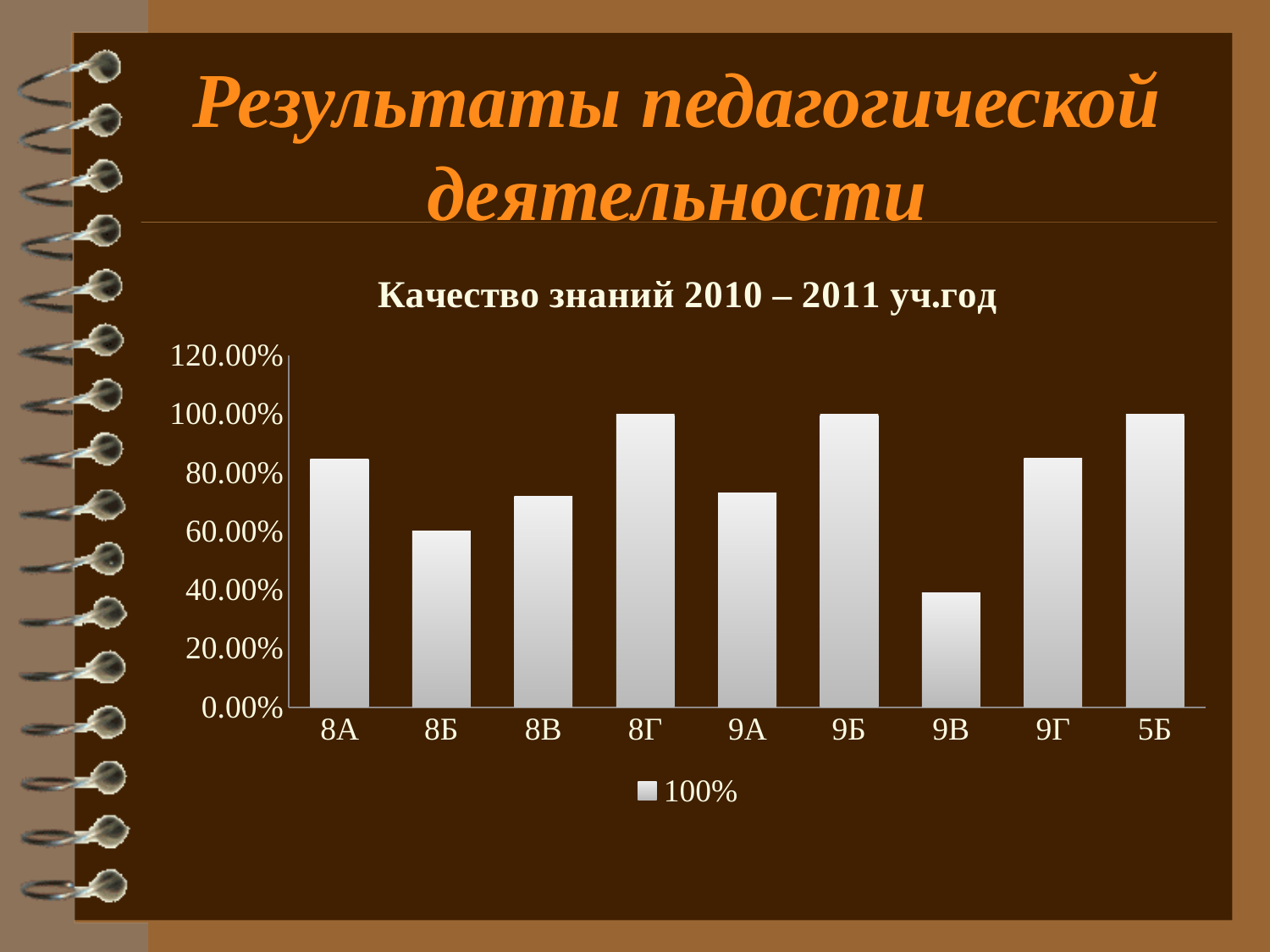
How many series does the chart legend list? 1 Which has the larger value, 9В or 9Г? 9Г Which category has the lowest value in the chart? 9В What entry is shown in the chart legend? 100% What is the value for 8Г in the chart? 100.00% How many categories are shown on the x axis of the chart? 9 Which has the larger value, 8А or 8Б? 8А What kind of chart is shown on the slide? bar chart Is the value for 8В greater or less than 80.00%? less What is the title of the chart? Качество знаний 2010 – 2011 уч.год Is the value for 9В greater or less than 60.00%? less Is the value for 8А greater or less than 80.00%? greater